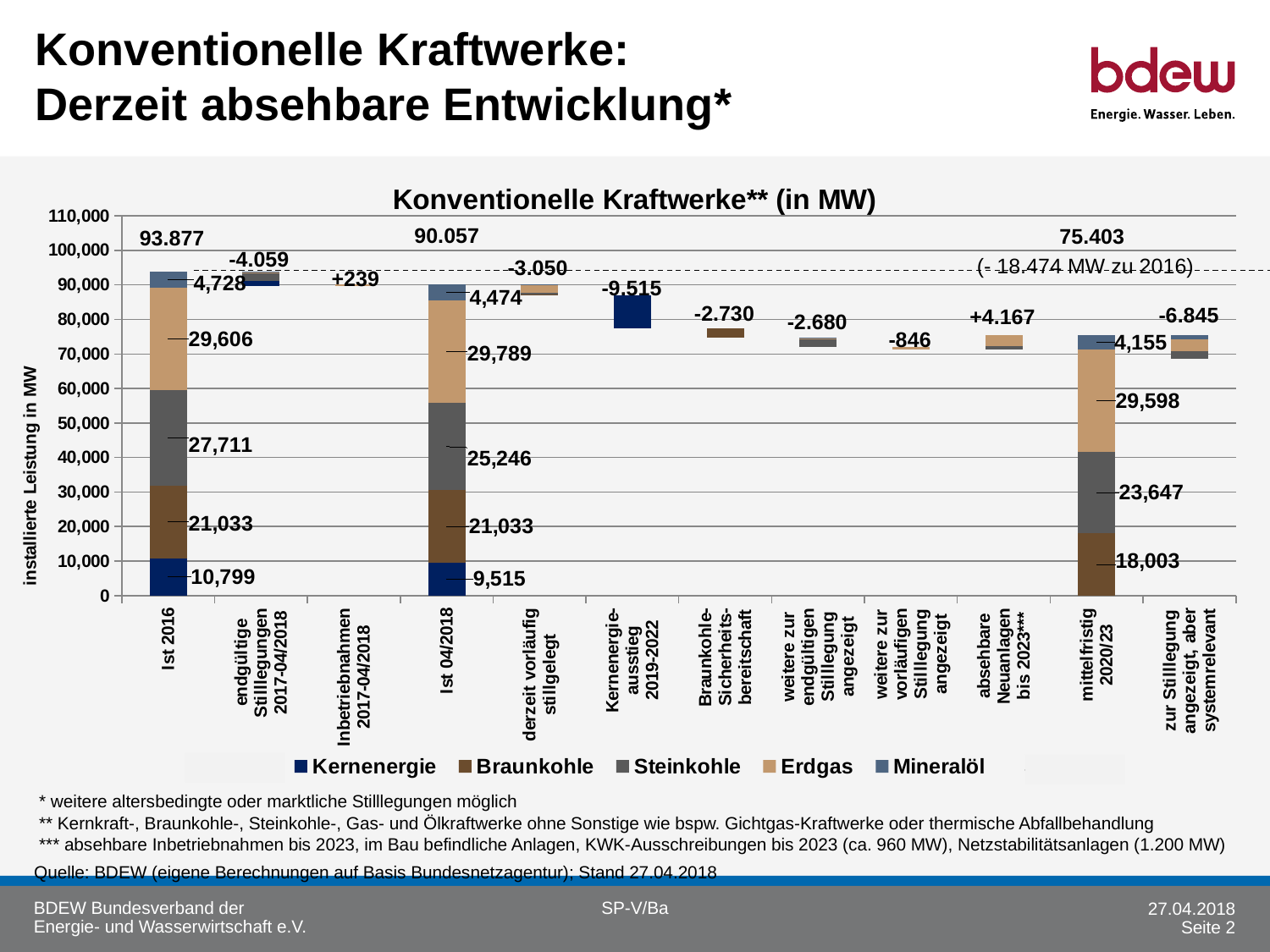
What value is labelled for "Kernenergieausstieg 2019-2022"? -9.515 What is the difference between the Steinkohle values in "Ist 2016" (27,711) and "mittelfristig 2020/23" (23,647)? 4,064 What is the Kernenergie value in the "Ist 2016" bar? 10,799 What is the total installed capacity shown for "Ist 04/2018"? 90.057 What is the total installed capacity shown for "mittelfristig 2020/23"? 75.403 How many categories are shown on the x axis? 12 What is the Steinkohle value in the "Ist 04/2018" bar? 25,246 What kind of chart is shown on the slide? Stacked bar chart How many series does the legend list? 5 Which is larger: the Erdgas value in "Ist 2016" or the Steinkohle value in "Ist 2016"? Erdgas (29,606) What is the total installed capacity shown for "Ist 2016"? 93.877 What value is labelled for "absehbare Neuanlagen bis 2023***"? +4.167